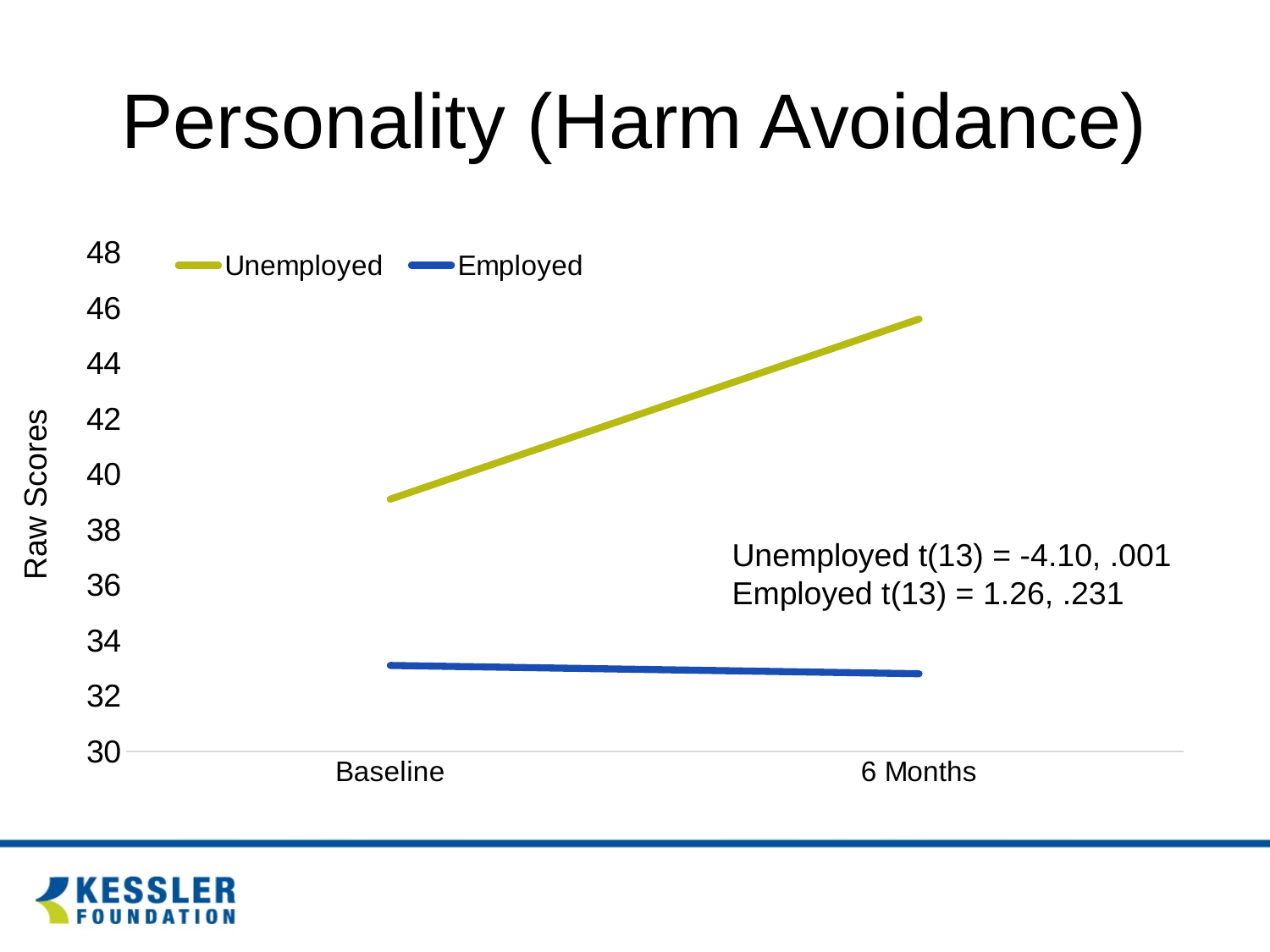
What colour is the Employed line? Blue At Baseline, which series has the larger value, Unemployed or Employed? Unemployed Is the value for Unemployed at 6 Months greater or less than 44? greater Does the Unemployed line rise or fall from Baseline to 6 Months? Rises Which series has the highest value at 6 Months? Unemployed Is the value for Unemployed at Baseline greater or less than 38? greater Is the value for Employed at 6 Months greater or less than 32? greater How many time points are shown on the x axis? 2 What is the title of the y axis? Raw Scores How many series does the legend list? 2 What kind of chart is shown on the slide? Line chart